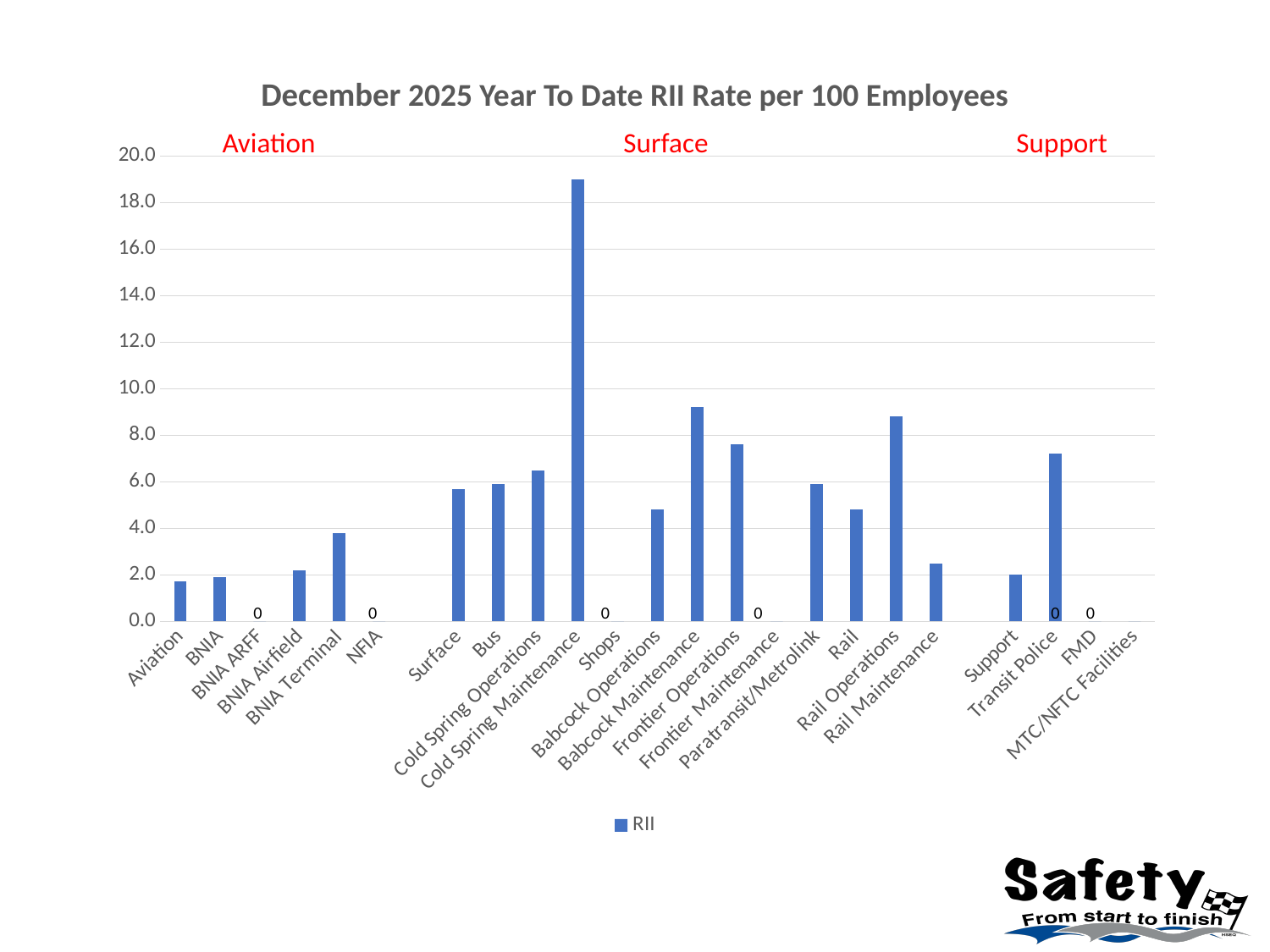
What is the RII rate for BNIA ARFF? 0 What is the name of the series shown in the legend? RII Is the RII rate for Babcock Maintenance greater or less than 8.0? greater What is the title of the chart? December 2025 Year To Date RII Rate per 100 Employees What kind of chart is shown on the slide? Bar chart Which category has the highest RII rate? Cold Spring Maintenance What is the RII rate for Shops? 0 How many categories are shown on the x axis? 23 Which has a higher RII rate, Babcock Operations or Babcock Maintenance? Babcock Maintenance Is the RII rate for Cold Spring Maintenance greater or less than 18.0? greater What is the RII rate for Frontier Maintenance? 0 How many series does the legend list? 1